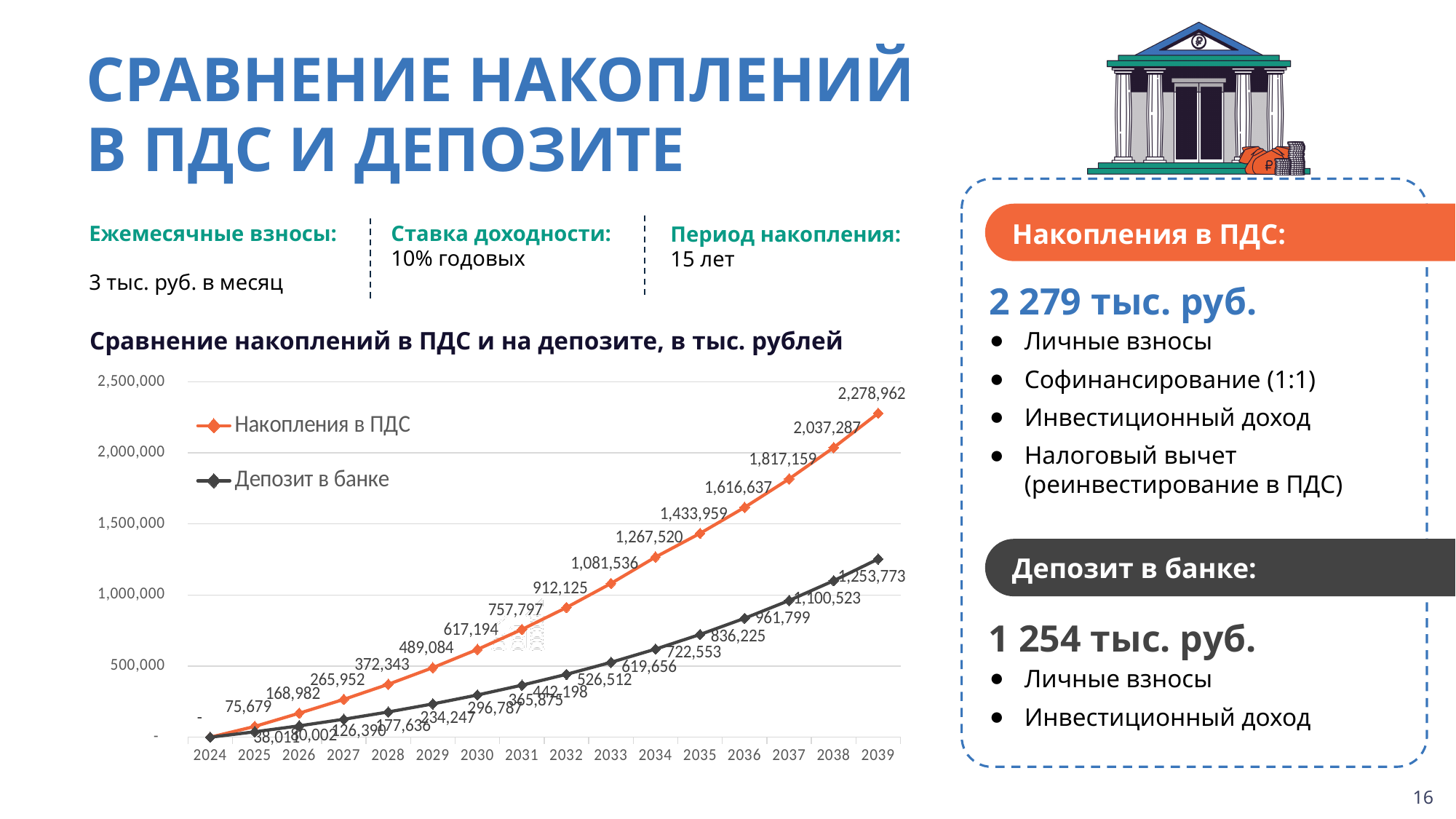
What is the difference between Накопления в ПДС and Депозит в банке in 2034? 647,864 In 2033, which series has the larger value: Накопления в ПДС or Депозит в банке? Накопления в ПДС What is the value for Накопления в ПДС in 2030? 617,194 What is the value for Депозит в банке in 2035? 722,553 What is the value for Депозит в банке in 2039? 1,253,773 What is the difference between Накопления в ПДС and Депозит в банке in 2039? 1,025,189 In which year does Накопления в ПДС reach its highest value? 2039 How many series does the chart legend list? 2 What is the value for Накопления в ПДС in 2039? 2,278,962 How many years are shown on the x axis of the chart? 16 What kind of chart is shown on the slide? line chart Do the values for Депозит в банке rise or fall from 2024 to 2039? rise